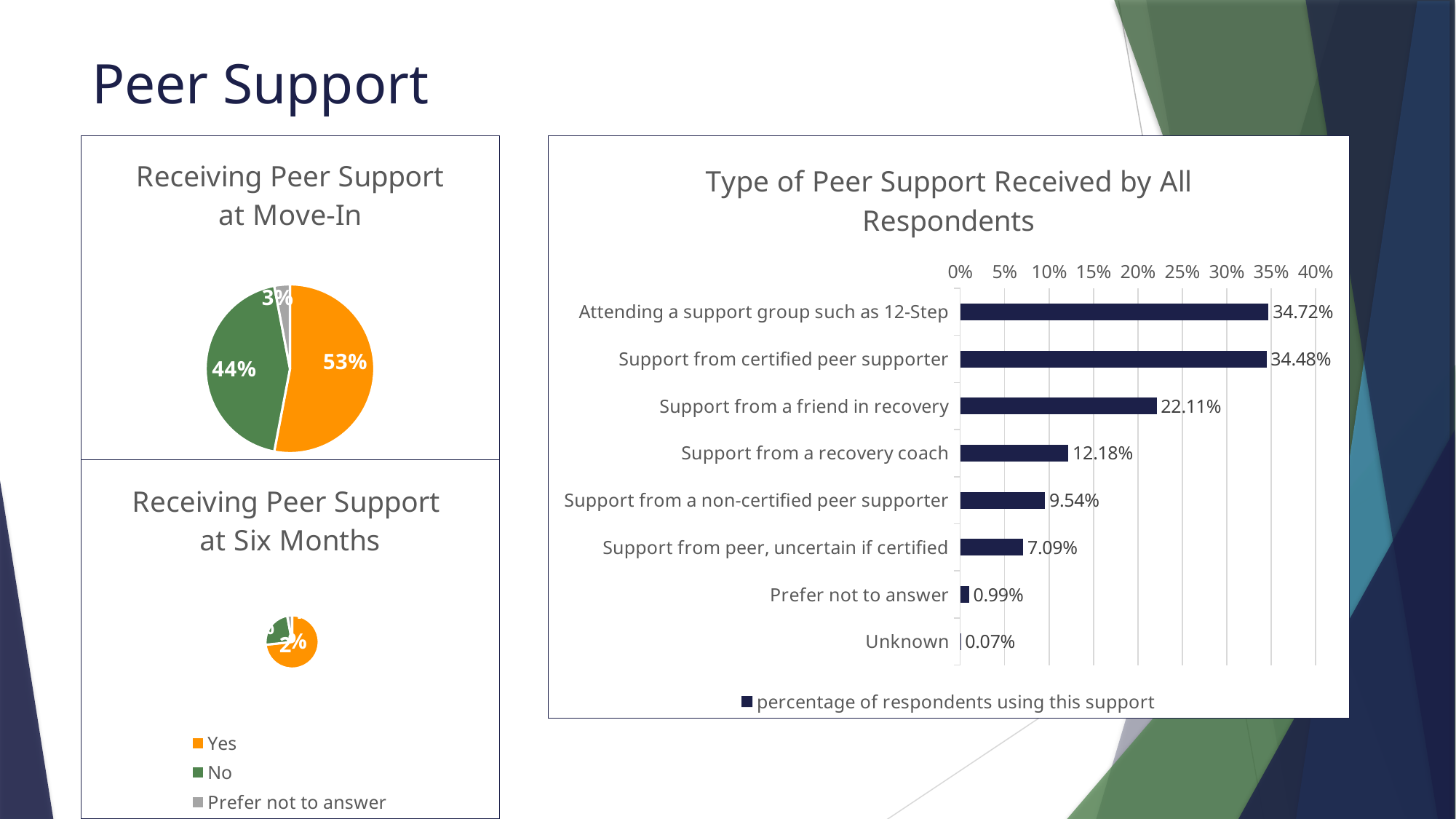
In the 'Receiving Peer Support at Move-In' pie chart, what share of respondents answered No? 44% In the 'Type of Peer Support Received by All Respondents' chart, which category has the lowest value? Unknown In the 'Type of Peer Support Received by All Respondents' chart, what is the difference between 'Support from a friend in recovery' and 'Support from a recovery coach'? 9.93% In the 'Type of Peer Support Received by All Respondents' chart, which is larger: 'Support from a non-certified peer supporter' or 'Support from peer, uncertain if certified'? Support from a non-certified peer supporter In the 'Receiving Peer Support at Move-In' pie chart, what share of respondents chose 'Prefer not to answer'? 3% In the 'Type of Peer Support Received by All Respondents' chart, what is the value for 'Support from a friend in recovery'? 22.11% What kind of chart is 'Type of Peer Support Received by All Respondents'? Bar chart How many categories are shown in the 'Type of Peer Support Received by All Respondents' chart? 8 In the 'Type of Peer Support Received by All Respondents' chart, which category has the highest value? Attending a support group such as 12-Step In the 'Receiving Peer Support at Move-In' pie chart, which response has the largest slice? Yes In the 'Type of Peer Support Received by All Respondents' chart, what is the value for 'Support from a recovery coach'? 12.18% In the 'Receiving Peer Support at Move-In' pie chart, what share of respondents answered Yes? 53%